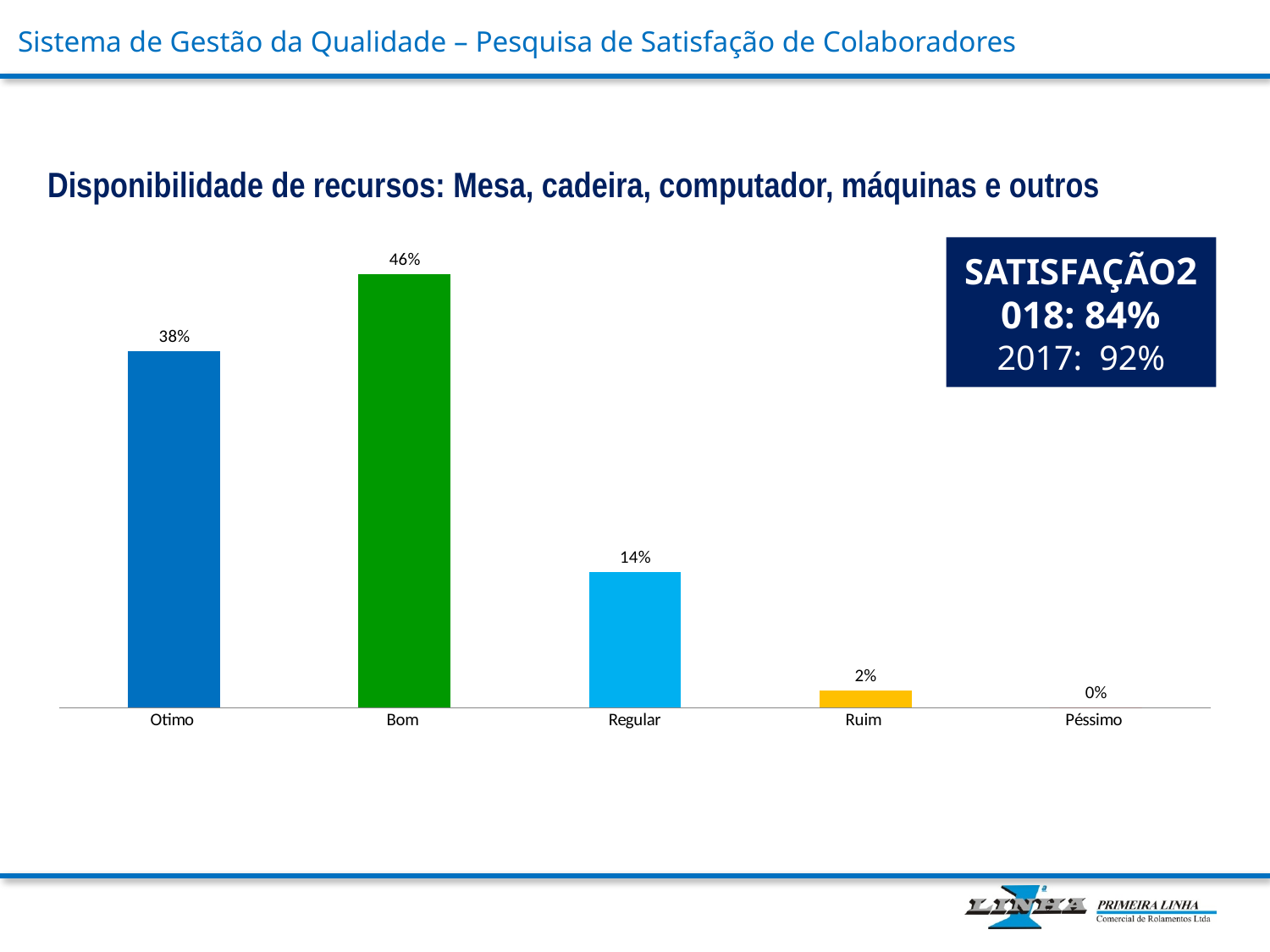
What is the title of the chart? Disponibilidade de recursos: Mesa, cadeira, computador, máquinas e outros Which category has the highest value? Bom What is the value for Otimo? 38% What is the value for Bom? 46% What is the difference between the values for Bom and Otimo? 8% What kind of chart is shown on the slide? Bar chart How many categories are shown on the x axis? 5 What is the value for Péssimo? 0% What is the value for Regular? 14% Which category has the lowest value? Péssimo Which is larger, the value for Regular or the value for Ruim? Regular What is the value for Ruim? 2%